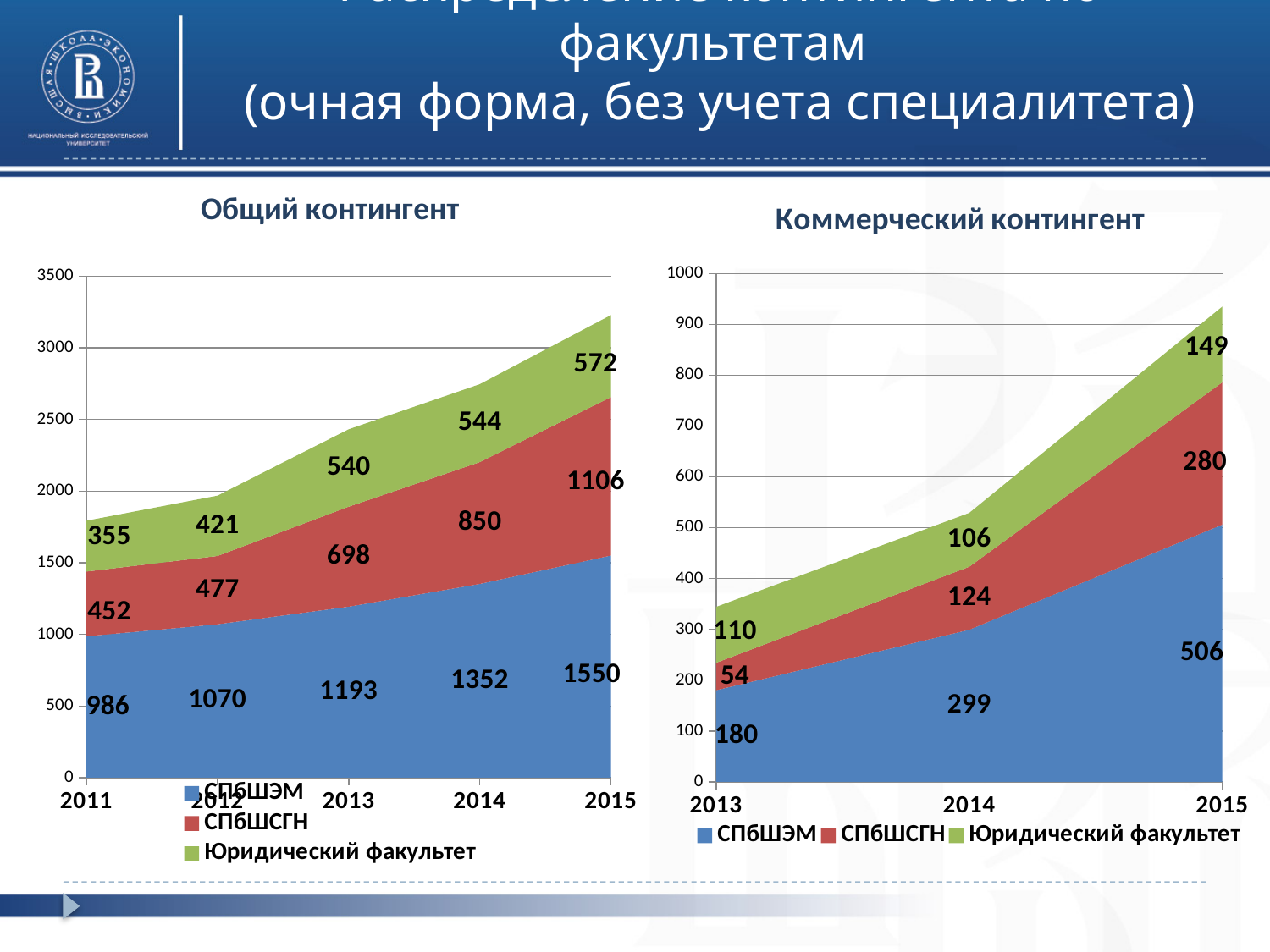
In the 'Коммерческий контингент' chart, in which year is the Юридический факультет value lowest? 2014 How many series does the legend of the 'Общий контингент' chart list? 3 In the 'Общий контингент' chart, what is the value for Юридический факультет in 2011? 355 In the 'Коммерческий контингент' chart, what is the value for СПбШСГН in 2014? 124 In the 'Общий контингент' chart, what is the difference between the СПбШСГН values in 2015 and 2014? 256 In the 'Общий контингент' chart, which is larger in 2012: СПбШСГН or Юридический факультет? СПбШСГН In the 'Коммерческий контингент' chart, what is the value for СПбШЭМ in 2015? 506 How many years are shown on the x axis of the 'Коммерческий контингент' chart? 3 In the 'Общий контингент' chart, what is the value for СПбШЭМ in 2013? 1193 In the 'Коммерческий контингент' chart, what is the total of all three series in 2013? 344 In the 'Общий контингент' chart, in which year is the СПбШЭМ value highest? 2015 In the 'Общий контингент' chart, what is the value for СПбШСГН in 2015? 1106